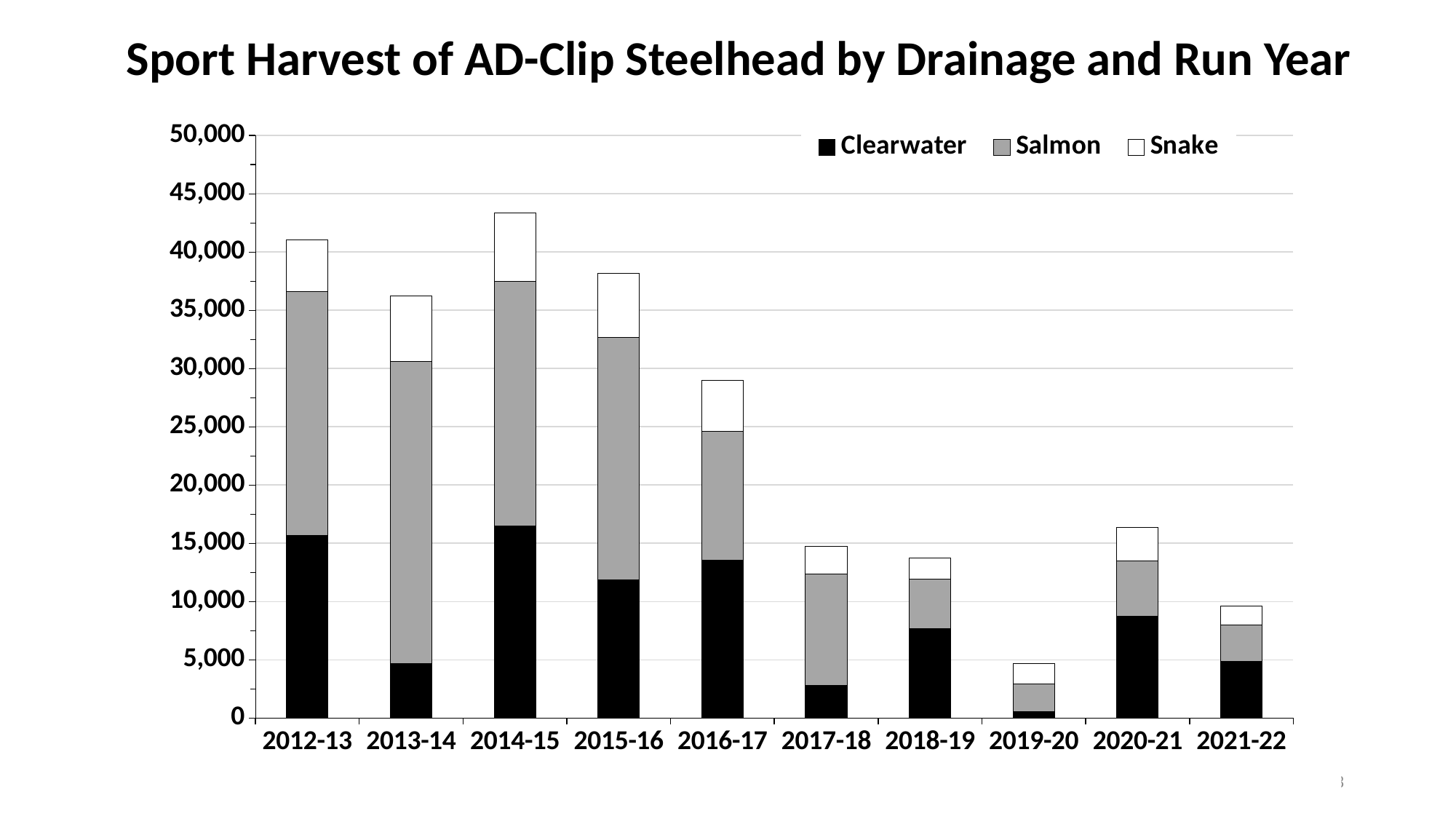
Which is larger, the total harvest in 2020-21 or in 2021-22? 2020-21 Overall, do the total harvest values rise or fall from 2012-13 to 2021-22? fall Is the Clearwater value for 2017-18 greater or less than 5,000? less Is the total harvest for 2014-15 greater or less than 40,000? greater Which run year has the highest total sport harvest? 2014-15 Which run year has the lowest total sport harvest? 2019-20 How many run years are shown on the x axis? 10 What kind of chart is shown on the slide? Stacked bar chart Which is larger, the Clearwater harvest in 2014-15 or in 2013-14? 2014-15 Is the total harvest for 2018-19 greater or less than 15,000? less How many series does the legend list? 3